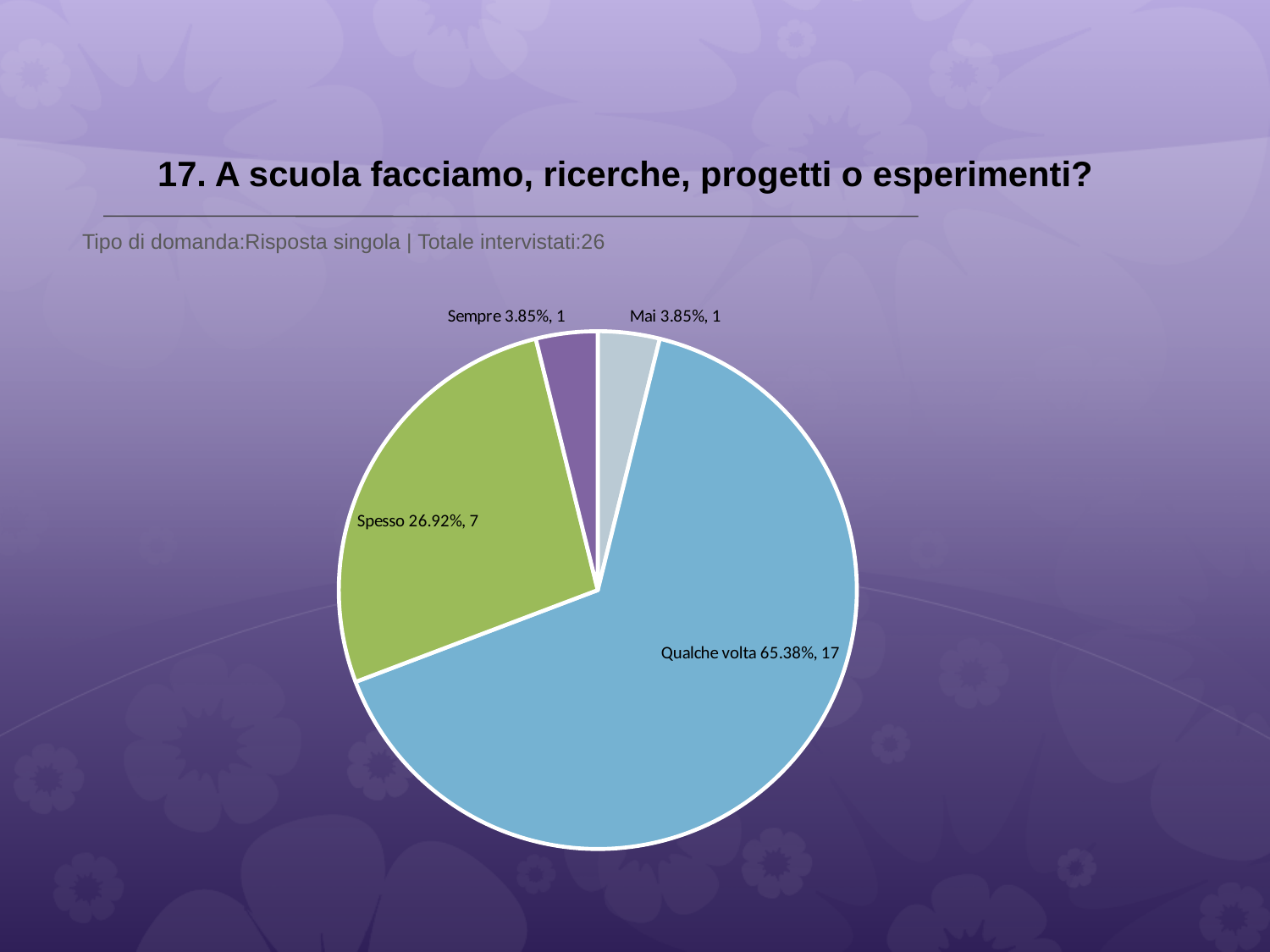
How many slices does the pie chart have? 4 What percentage share does the 'Qualche volta' slice have? 65.38% Which category has the largest slice? Qualche volta What is the title of the chart? 17. A scuola facciamo, ricerche, progetti o esperimenti? Which is larger, the 'Spesso' slice or the 'Sempre' slice? Spesso What percentage share does the 'Spesso' slice have? 26.92% How many respondents answered 'Spesso'? 7 What is the difference in respondent count between 'Qualche volta' and 'Spesso'? 10 What is the total number of respondents shown on the slide? 26 What percentage share does the 'Mai' slice have? 3.85% What kind of chart is shown on the slide? pie chart How many respondents answered 'Sempre'? 1